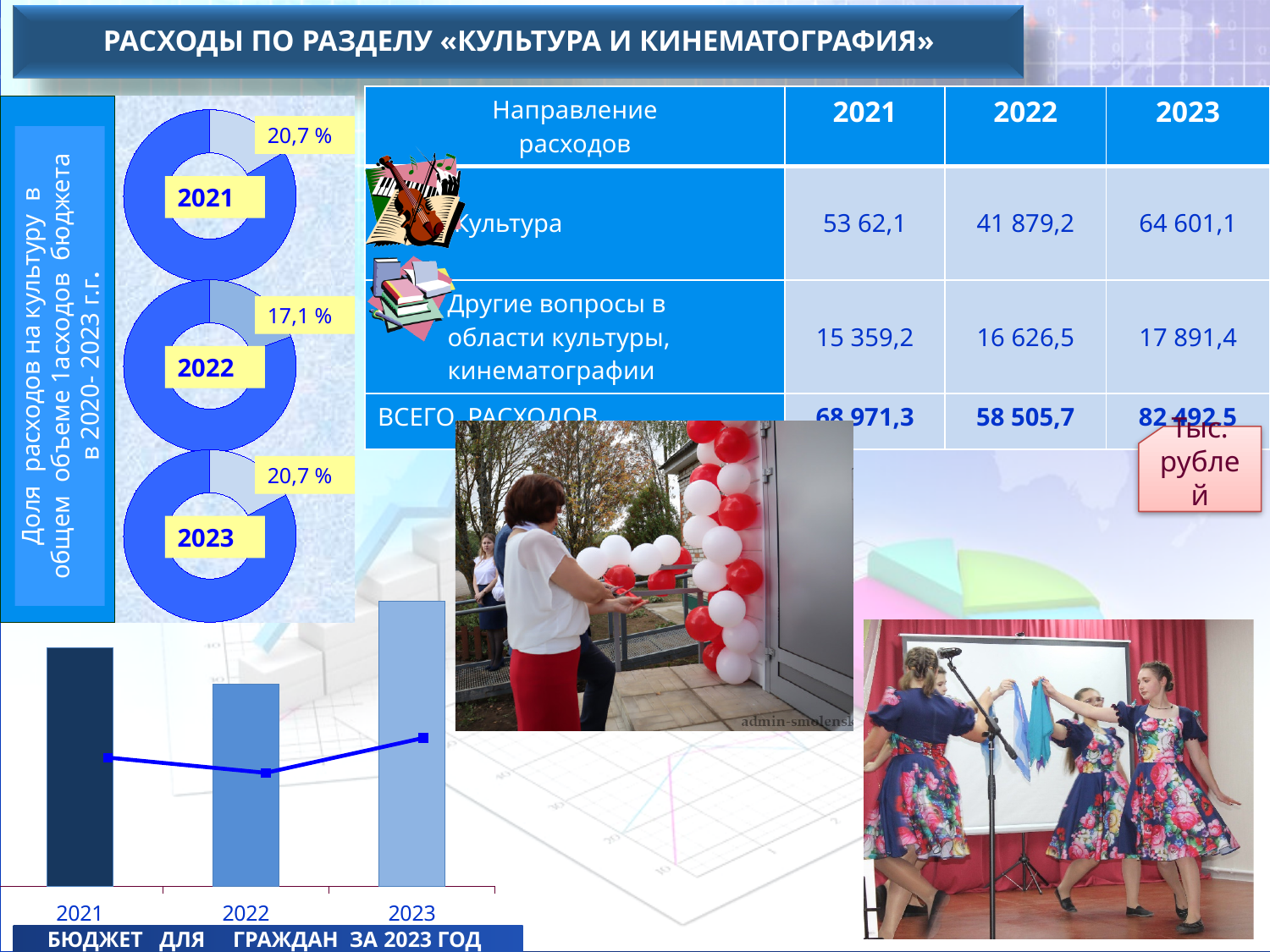
In the donut chart for 2022, what share of the budget is spent on culture? 17,1 % In the bottom-left bar chart, is the bar for 2023 taller or shorter than the bar for 2022? taller In the bottom-left bar chart, which year has the shortest bar? 2022 In the bottom-left bar chart, which year has the tallest bar? 2023 How many donut charts are shown on the left side of the slide? 3 Comparing the donut charts, which year has the larger share of culture expenditures, 2021 or 2022? 2021 By how many percentage points does the share in the 2021 donut chart exceed the share in the 2022 donut chart? 3,6 % How many bars are in the bottom-left bar chart? 3 In the donut chart for 2023, what share of the budget is spent on culture? 20,7 % Among the three donut charts, which year has the lowest share of culture expenditures? 2022 In the donut chart for 2021, what share of the budget is spent on culture? 20,7 % What kind of chart is shown in the bottom-left corner of the slide? bar chart